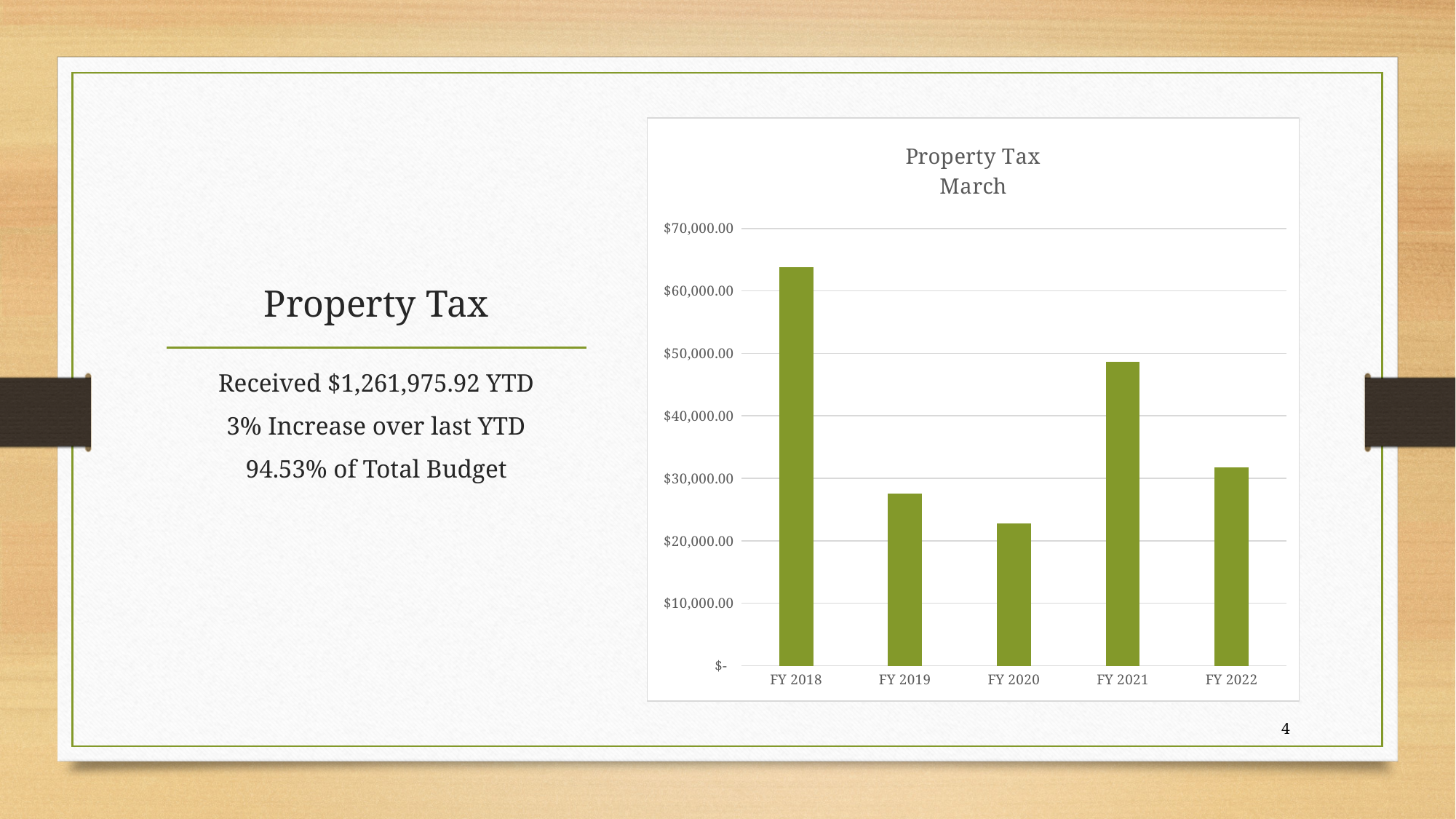
Is the value for FY 2021 greater or less than $50,000.00? less Is the value for FY 2022 greater or less than $30,000.00? greater Is the value for FY 2019 greater or less than $30,000.00? less What kind of chart is shown on the slide? bar chart Which is larger, the value for FY 2019 or the value for FY 2020? FY 2019 Which fiscal year has the highest property tax value for March? FY 2018 Which is larger, the value for FY 2021 or the value for FY 2022? FY 2021 How many fiscal years are shown on the x axis of the chart? 5 Which fiscal year has the lowest property tax value for March? FY 2020 What is the title of the chart? Property Tax March